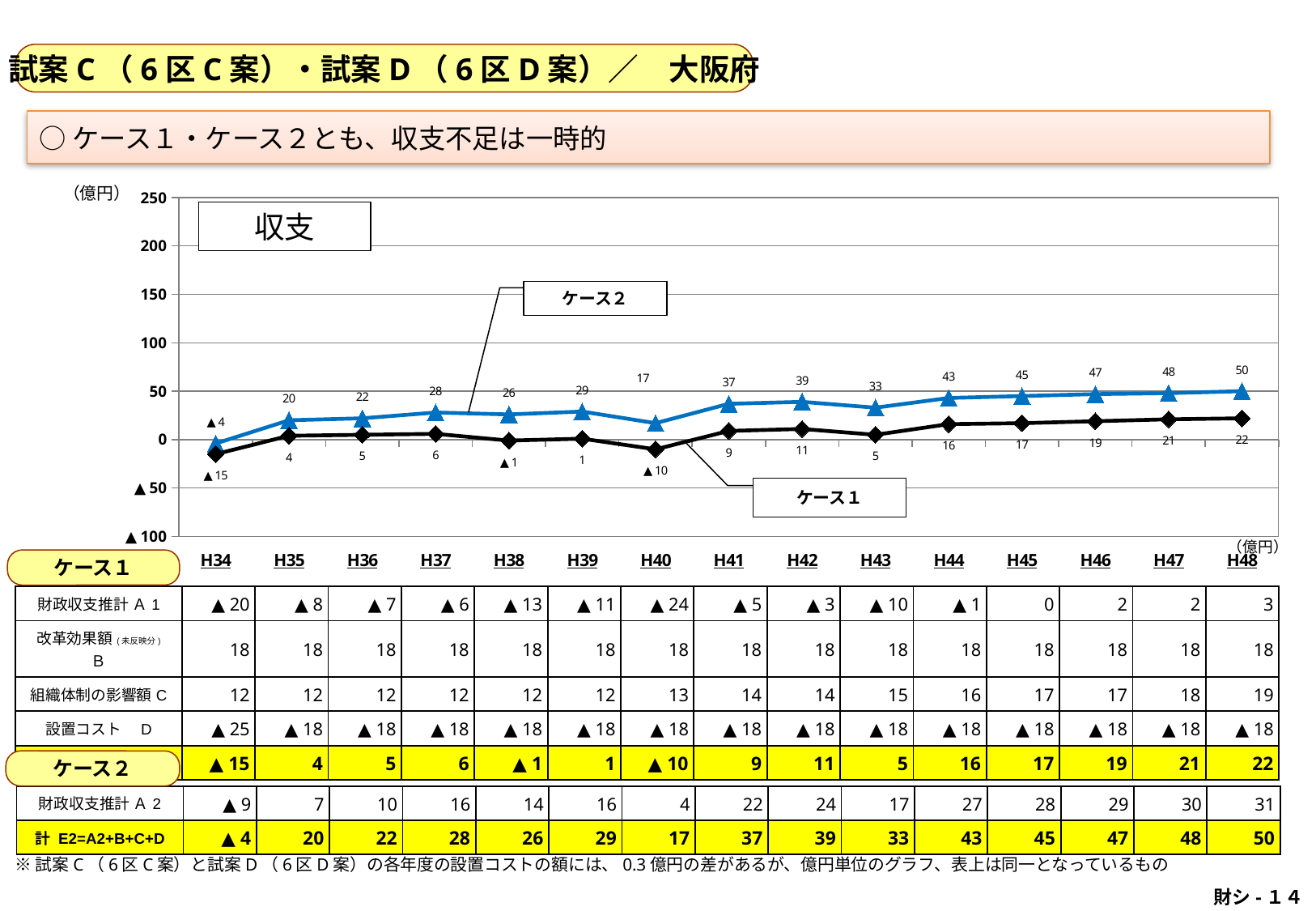
What kind of chart is shown on the slide? line chart Which is larger in H41, ケース1 or ケース2? ケース2 What is the title of the chart? 収支 What is the value for ケース2 in H48? 50 In which year is ケース2 at its highest? H48 How many series are plotted in the chart? 2 How many years (data points) are plotted along the x axis of the chart? 15 What is the difference between ケース2 and ケース1 in H48? 28 Is the value for ケース2 in H44 greater or less than 50? less In which year is ケース1 at its lowest? H34 What is the value for ケース2 in H40? 17 What is the value for ケース1 in H34? ▲15